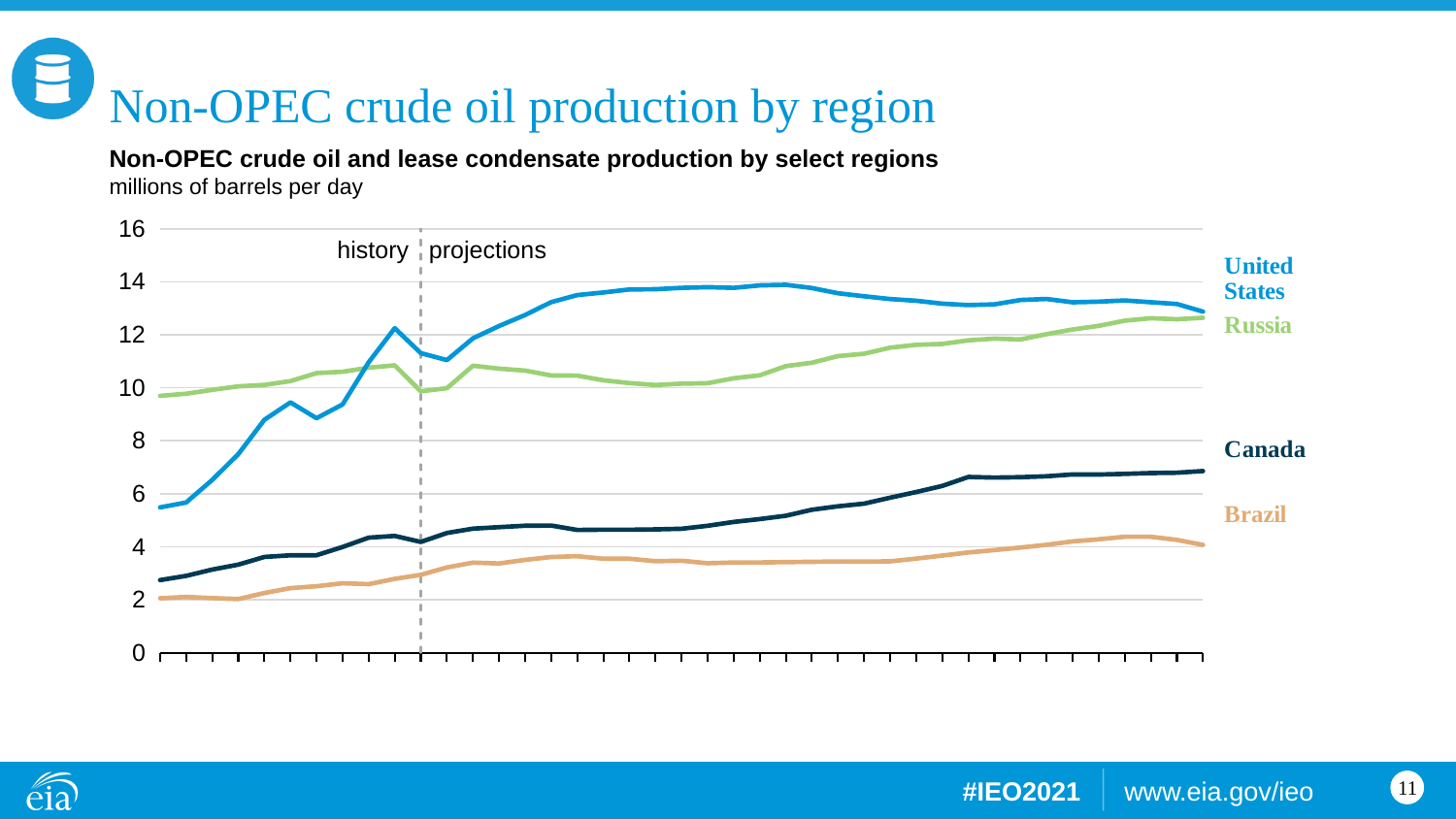
What kind of chart is shown on the slide? line chart Is the value for Russia at the start of the chart greater or less than 8? greater Which region has the lowest production at the right (end) of the chart? Brazil Is the value for Brazil at the end of the chart greater or less than 6? less Which region has the highest production at the left (start) of the chart? Russia Does the Canada line generally rise or fall along the x axis? rise What unit is the chart measured in? millions of barrels per day How many regions (series) are plotted on the chart? 4 Is the value for Canada at the end of the chart greater or less than 6? greater At the start of the chart, which is larger: production for the United States or for Russia? Russia At the end of the chart, which is larger: production for Canada or for Brazil? Canada What two periods does the dashed vertical line separate on the chart? history and projections